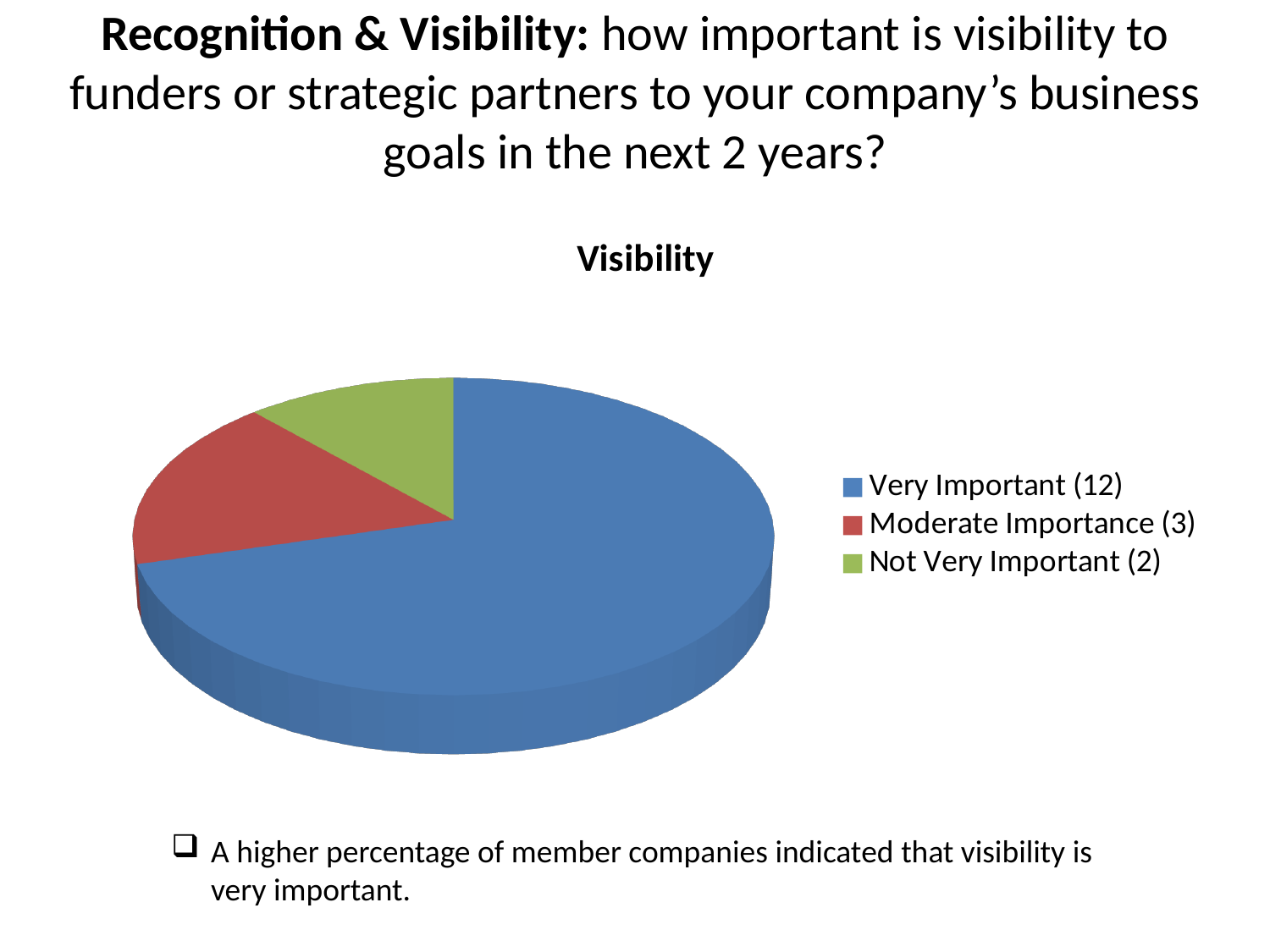
What colour is the Very Important slice? blue Which category has the largest slice of the pie? Very Important What kind of chart is shown on the slide? pie chart What is the total number of responses across all slices? 17 What is the title of the chart? Visibility Which category has the smallest slice of the pie? Not Very Important How many responses are shown for Very Important? 12 How many responses are shown for Moderate Importance? 3 How many categories does the pie chart have? 3 Which has more responses, Moderate Importance or Not Very Important? Moderate Importance What is the difference between the number of Very Important and Moderate Importance responses? 9 How many responses are shown for Not Very Important? 2